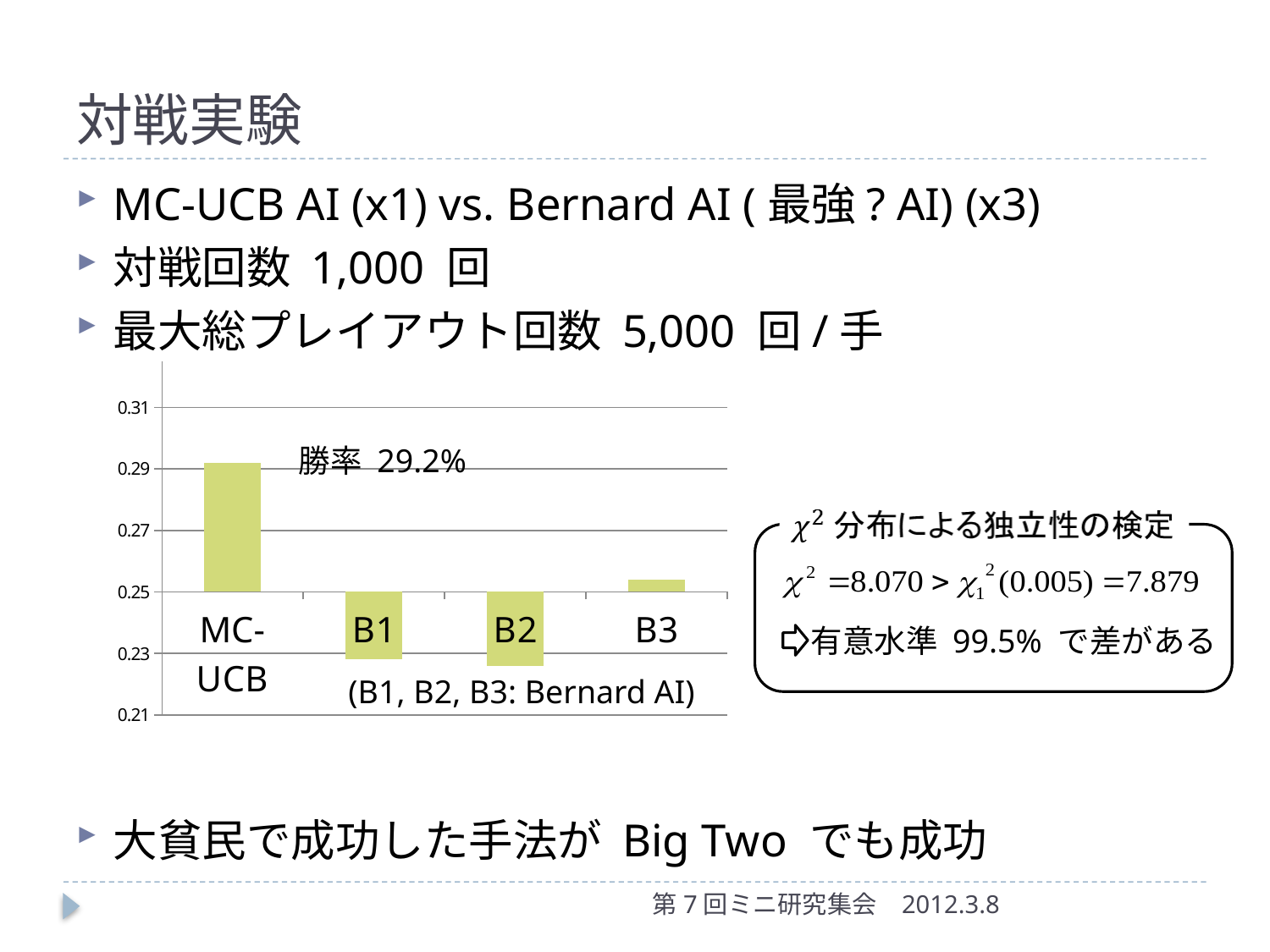
Which category has the highest value in the chart? MC-UCB Is the value for B3 greater or less than 0.27? less How many categories are plotted on the x axis of the chart? 4 According to the note under the chart, what do B1, B2 and B3 stand for? Bernard AI What kind of chart is shown on the slide? bar chart Is the value for B3 greater or less than 0.25? greater Which is larger, the value for MC-UCB or the value for B3? MC-UCB Is the value for MC-UCB greater or less than 0.27? greater What is the lowest tick value shown on the chart's y axis? 0.21 What win rate (勝率) is annotated for MC-UCB in the chart? 29.2% Which is larger, the value for B3 or the value for B1? B3